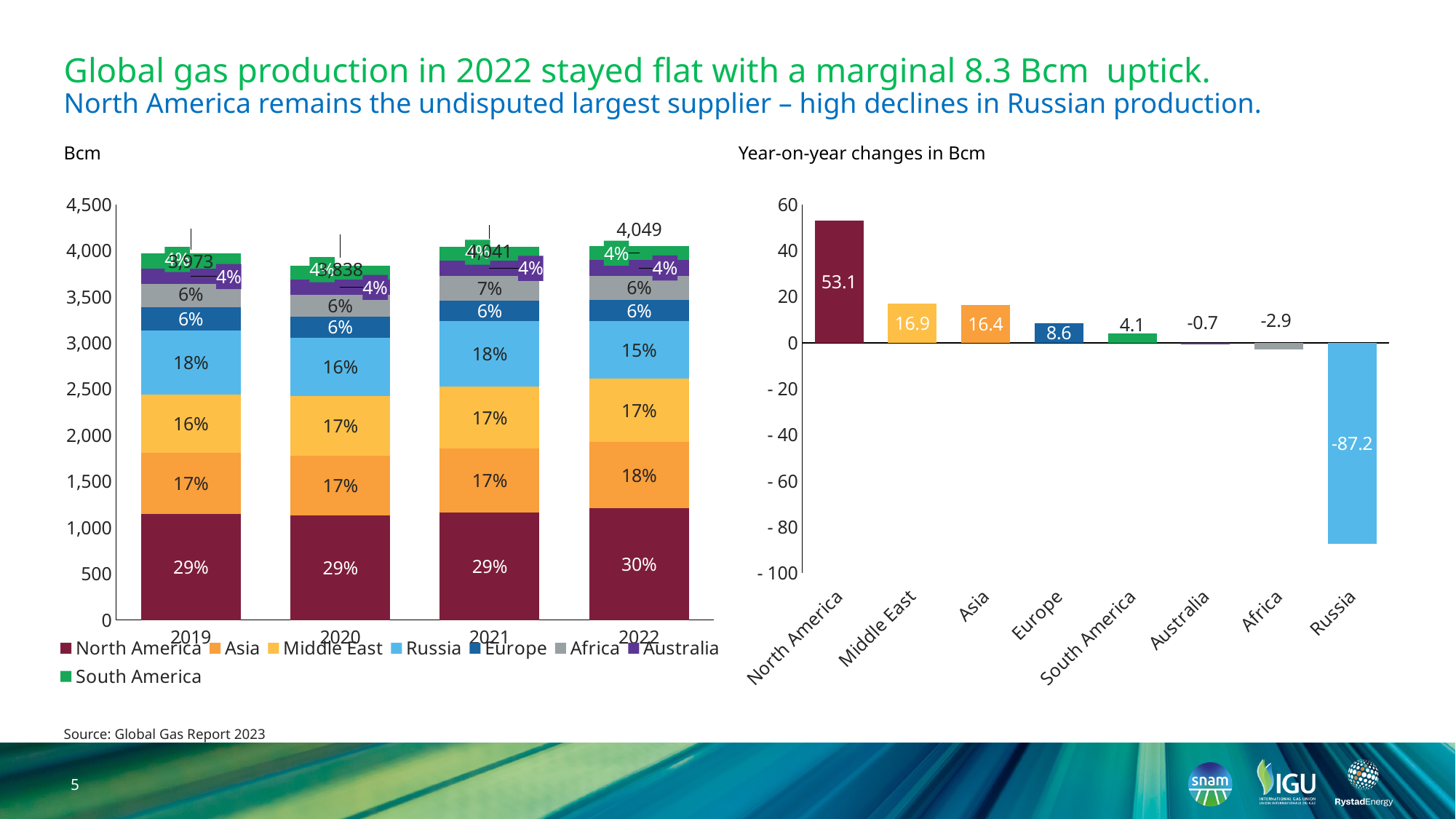
In the 'Year-on-year changes in Bcm' chart, which region has the lowest value? Russia In the 'Year-on-year changes in Bcm' chart, which is larger, the value for Europe or the value for South America? Europe In the 'Year-on-year changes in Bcm' chart, what is the value for North America? 53.1 In the left 'Bcm' chart, what is the total labelled on the 2022 bar? 4,049 In the left 'Bcm' chart, what percentage share does North America have in 2022? 30% How many series does the legend of the left 'Bcm' chart list? 8 In the 'Year-on-year changes in Bcm' chart, what is the value for Africa? -2.9 In the left 'Bcm' chart, what percentage share does Russia have in 2019? 18% In the 'Year-on-year changes in Bcm' chart, which region has the highest value? North America In the 'Year-on-year changes in Bcm' chart, how many regions are shown? 8 In the 'Year-on-year changes in Bcm' chart, what is the value for Russia? -87.2 In the 'Year-on-year changes in Bcm' chart, what is the difference between the values for Middle East and Asia? 0.5